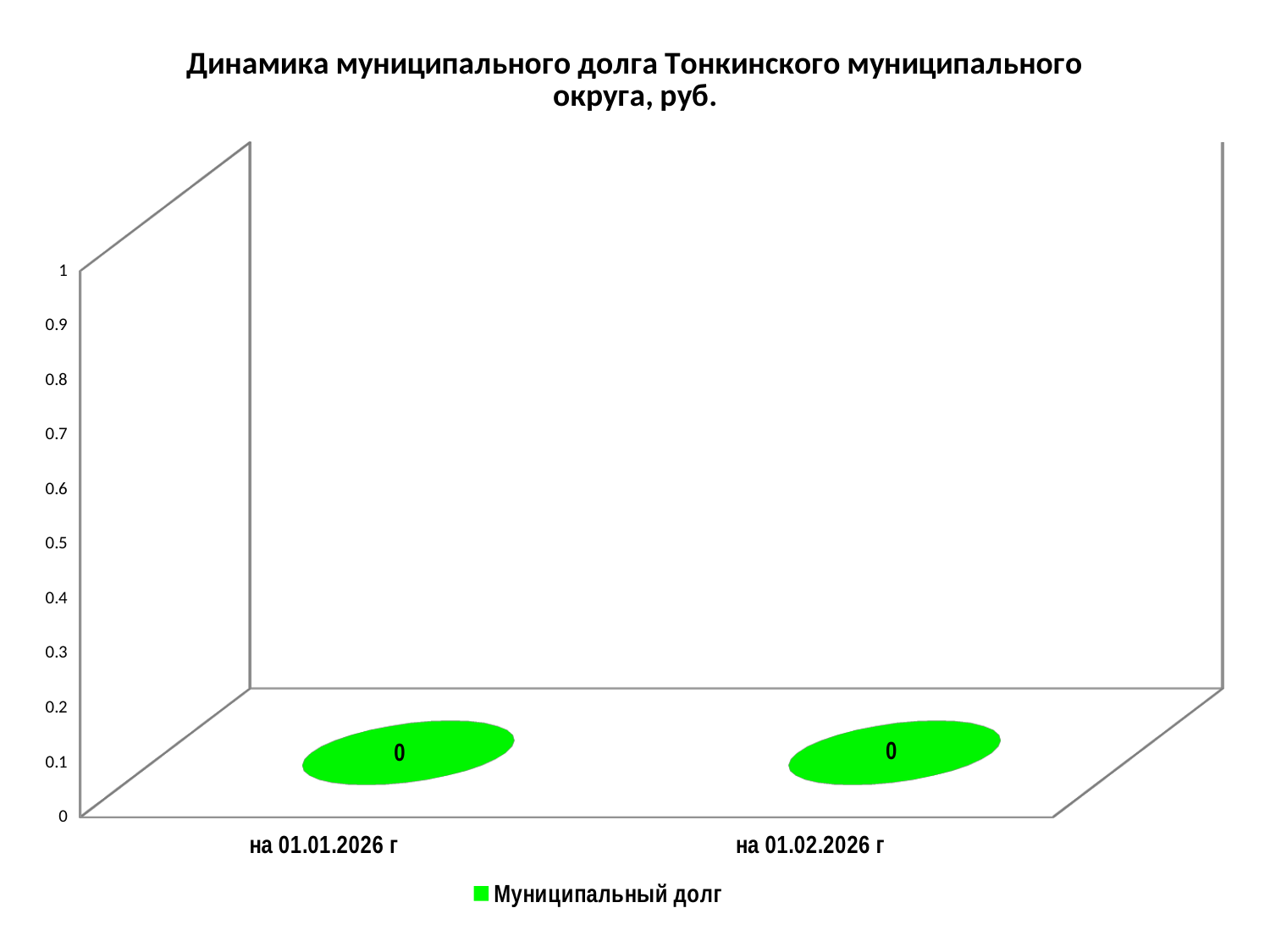
What is the difference between the values на 01.01.2026 г and на 01.02.2026 г? 0 What is the name of the series shown in the legend? Муниципальный долг What is the title of the chart? Динамика муниципального долга Тонкинского муниципального округа, руб. Do the values rise, fall or stay the same from на 01.01.2026 г to на 01.02.2026 г? stay the same What is the value of Муниципальный долг на 01.01.2026 г? 0 What kind of chart is shown on the slide? bar chart How many categories are shown on the x axis? 2 Is the value for на 01.01.2026 г greater or less than 0.5? less How many series does the legend list? 1 Is the value for на 01.02.2026 г greater or less than 0.5? less What is the value of Муниципальный долг на 01.02.2026 г? 0